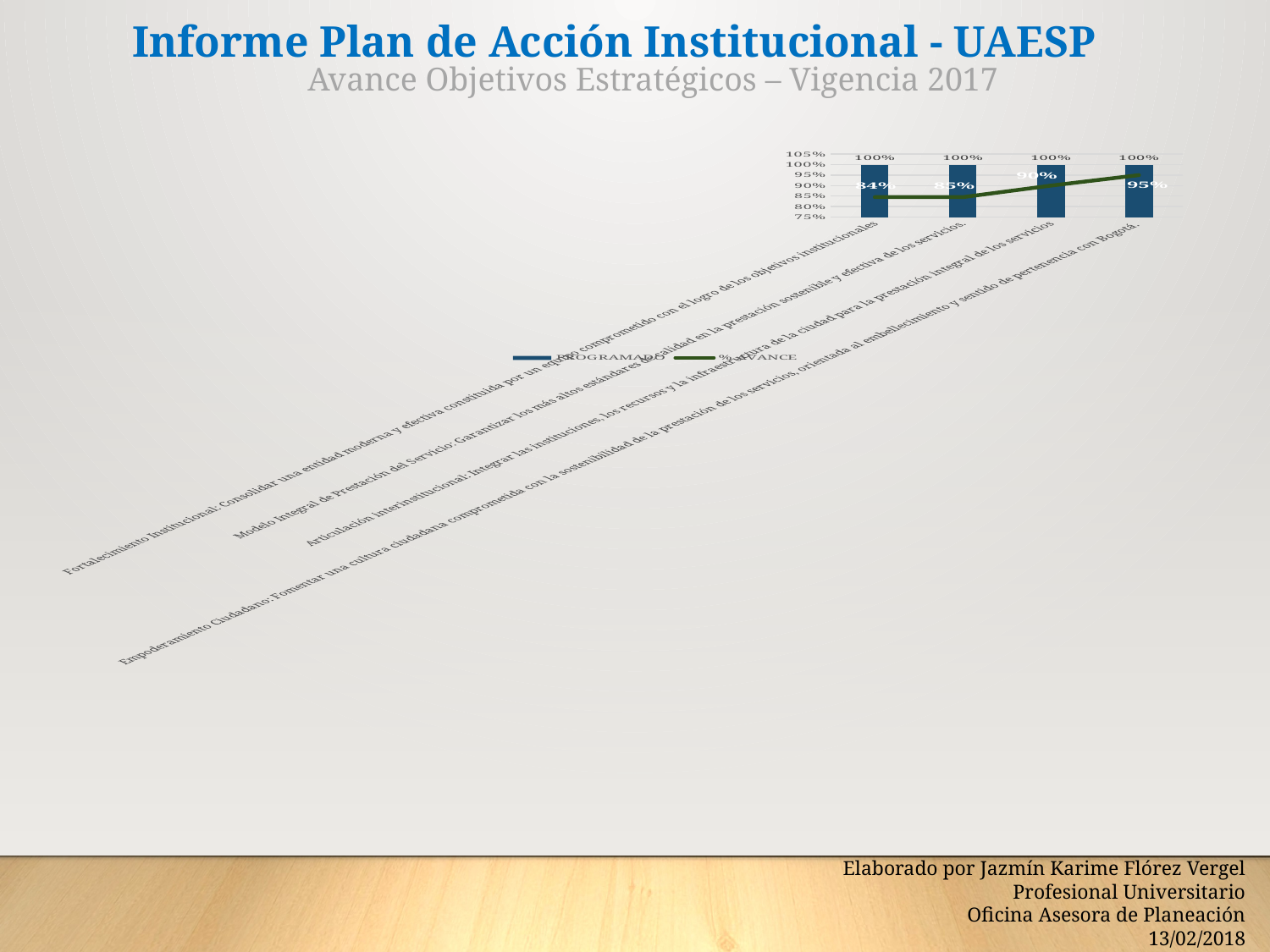
How many objectives (categories) are shown on the x axis of the chart? 4 Does the % AVANCE line rise or fall from left to right across the objectives? Rises Which is larger, the % AVANCE for Empoderamiento Ciudadano or for Modelo Integral de Prestación del Servicio? Empoderamiento Ciudadano What are the two series named in the chart legend? PROGRAMADO and % AVANCE How many series does the chart legend list? 2 What is the % AVANCE value for the Articulación interinstitucional objective? 90% What is the % AVANCE value for the Modelo Integral de Prestación del Servicio objective? 85% Which objective has the highest % AVANCE? Empoderamiento Ciudadano Which objective has the lowest % AVANCE? Fortalecimiento Institucional What is the % AVANCE value for the Empoderamiento Ciudadano objective? 95% What is the difference between the PROGRAMADO value and the % AVANCE value for the Articulación interinstitucional objective? 10% What is the PROGRAMADO value for the Fortalecimiento Institucional objective? 100%